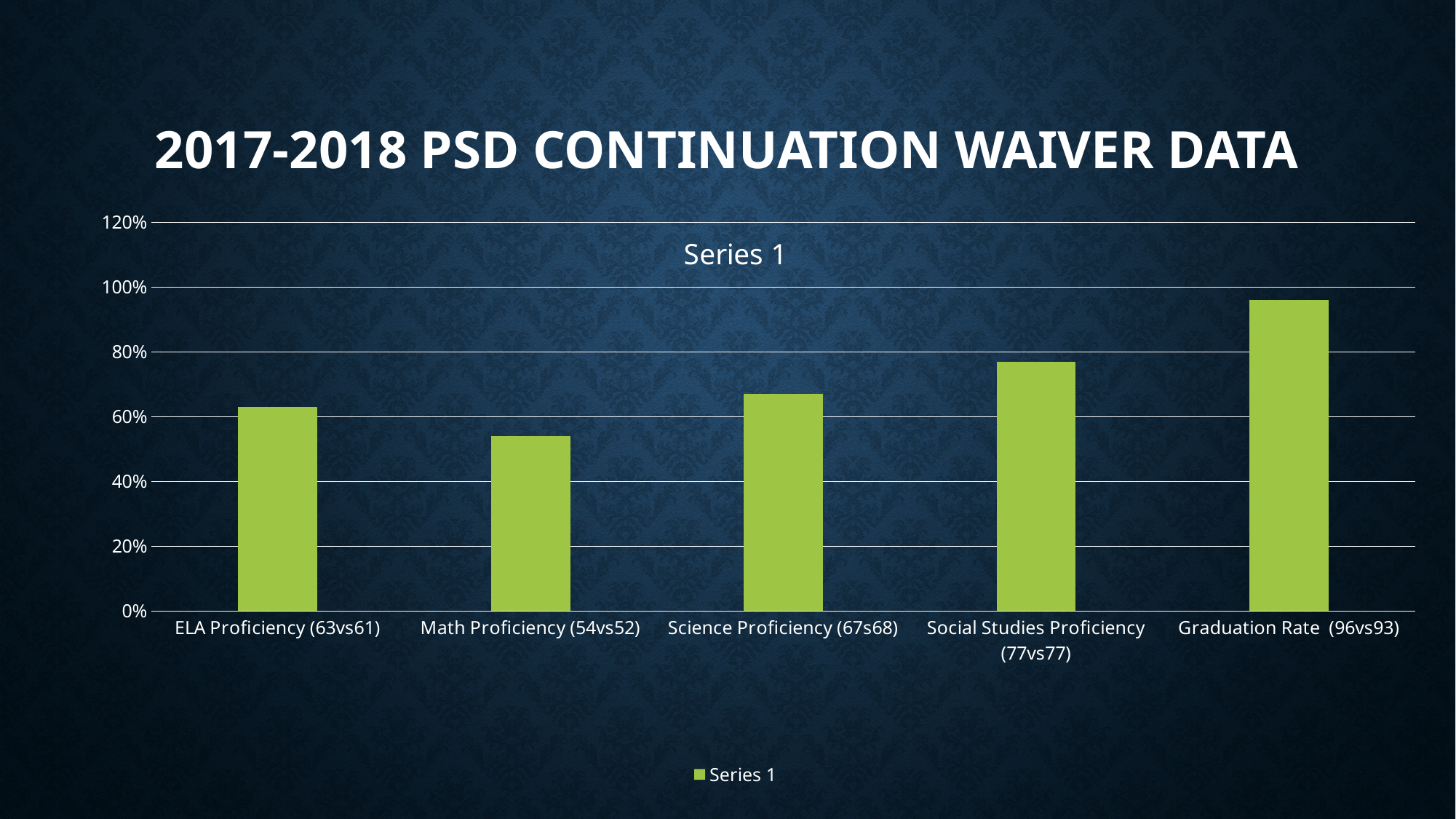
Is the value for Graduation Rate (96vs93) greater or less than 80%? greater Is the value for Math Proficiency (54vs52) greater or less than 60%? less How many series does the legend list? 1 Which category has the highest bar? Graduation Rate (96vs93) Is the value for Social Studies Proficiency (77vs77) greater or less than 60%? greater How many categories are plotted on the chart? 5 What is the name of the series shown in the legend? Series 1 Which is larger, the value for Science Proficiency (67s68) or the value for Math Proficiency (54vs52)? Science Proficiency (67s68) What is the title of the slide? 2017-2018 PSD Continuation Waiver Data What kind of chart is shown on the slide? bar chart Which category has the lowest bar? Math Proficiency (54vs52)